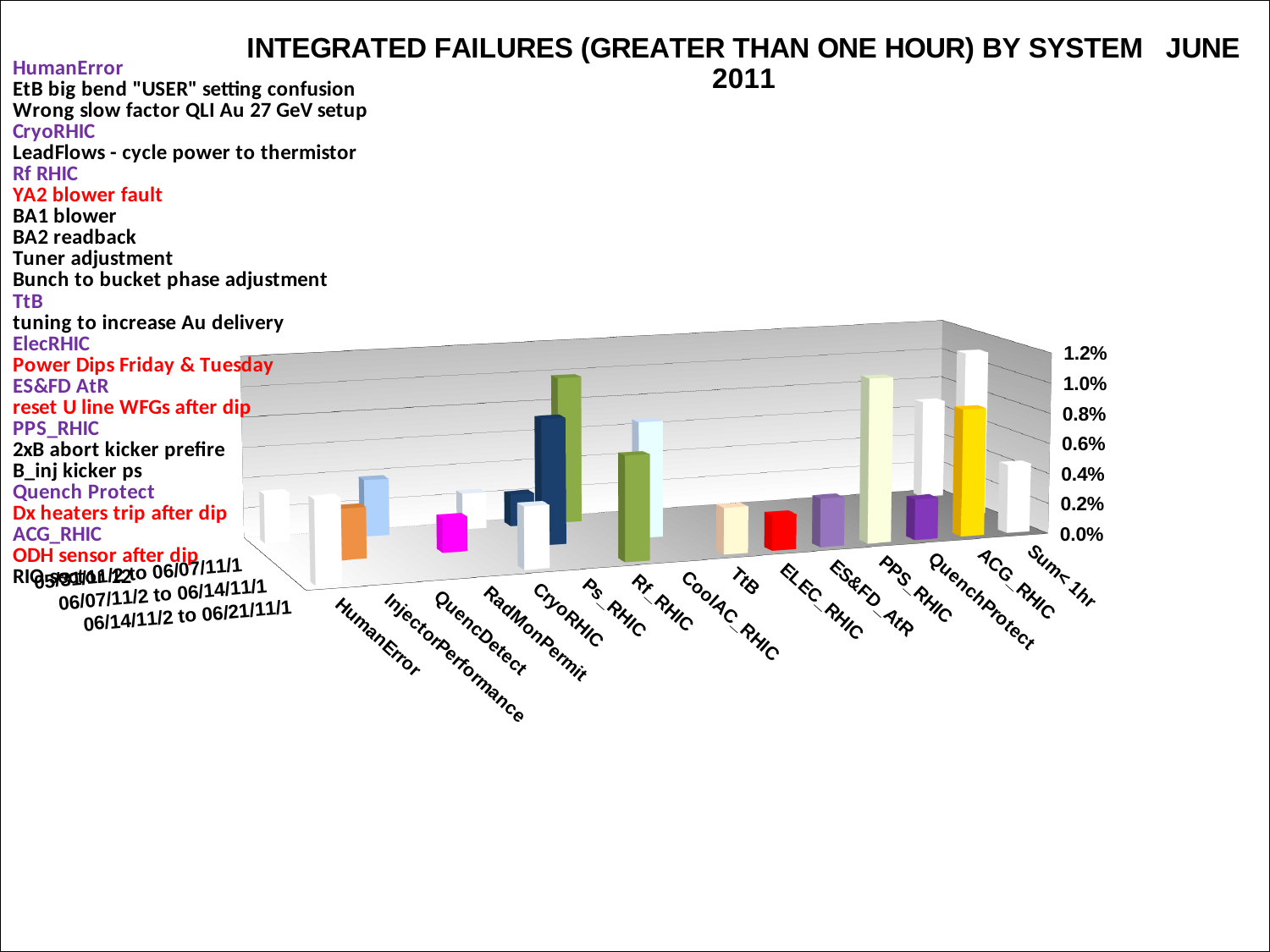
Is the value for ELEC_RHIC greater or less than 0.4%? less How many date-range series does the chart show? 3 What kind of chart is shown on the slide? bar chart What is the highest tick value shown on the vertical axis? 1.2% How many system categories are shown along the x axis of the chart? 15 What is the title of the chart? INTEGRATED FAILURES (GREATER THAN ONE HOUR) BY SYSTEM JUNE 2011 Is the value for TtB greater or less than 0.4%? less